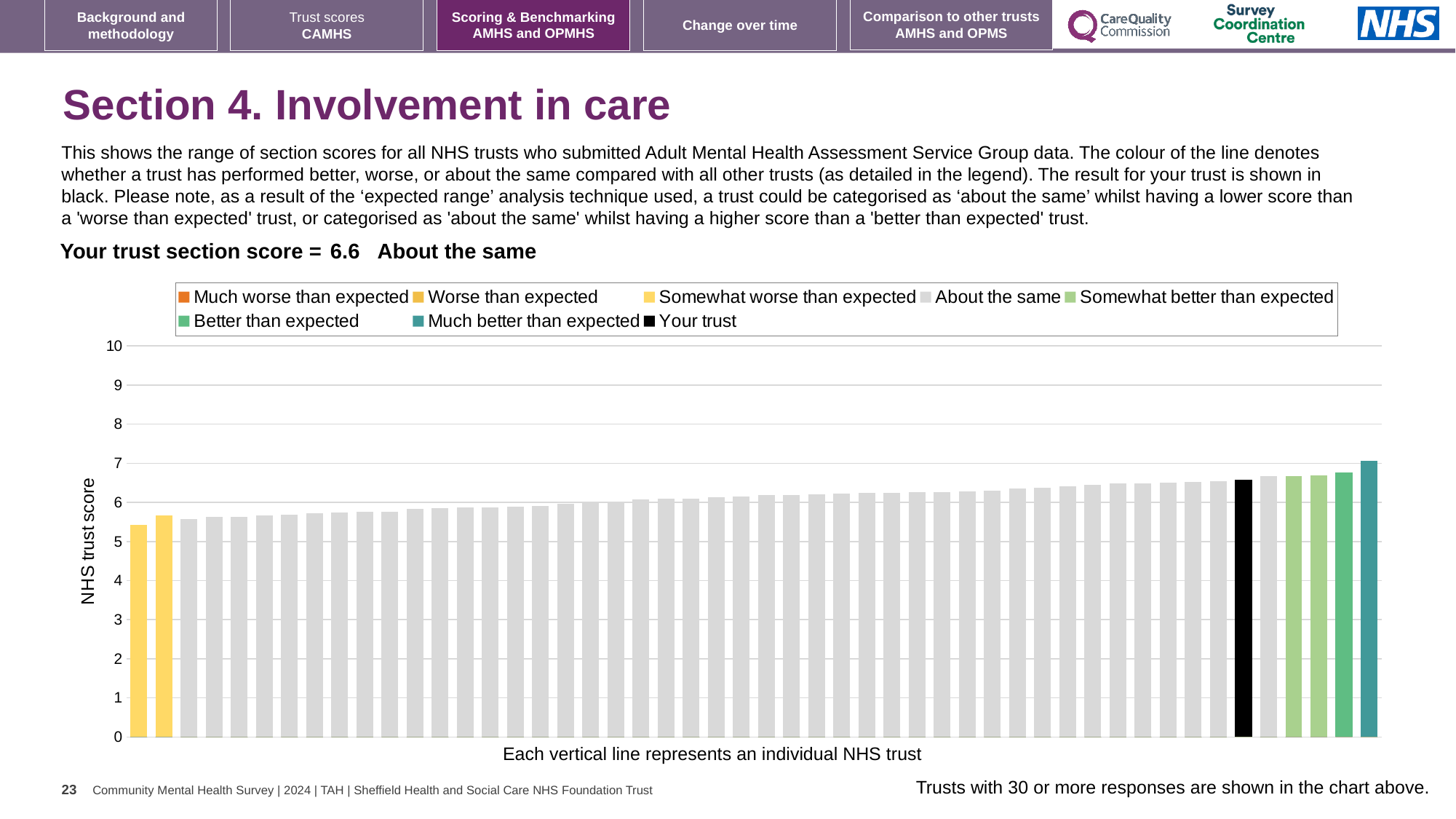
What kind of chart is shown on the slide? bar chart Do the bar values rise or fall from left to right along the x axis? rise Is the value of the black 'Your trust' bar greater or less than 6? greater Which legend category does the tallest bar in the chart belong to? Much better than expected What is your trust's section score for Involvement in care? 6.6 How many entries does the chart legend list? 8 Is the value of the leftmost (lowest) bar greater or less than 5? greater Is the value of the leftmost (lowest) bar greater or less than 6? less Is the 'Your trust' bar taller or shorter than the leftmost yellow bar? taller What is the label on the vertical axis of the chart? NHS trust score How is your trust categorised compared with other trusts in this section? About the same